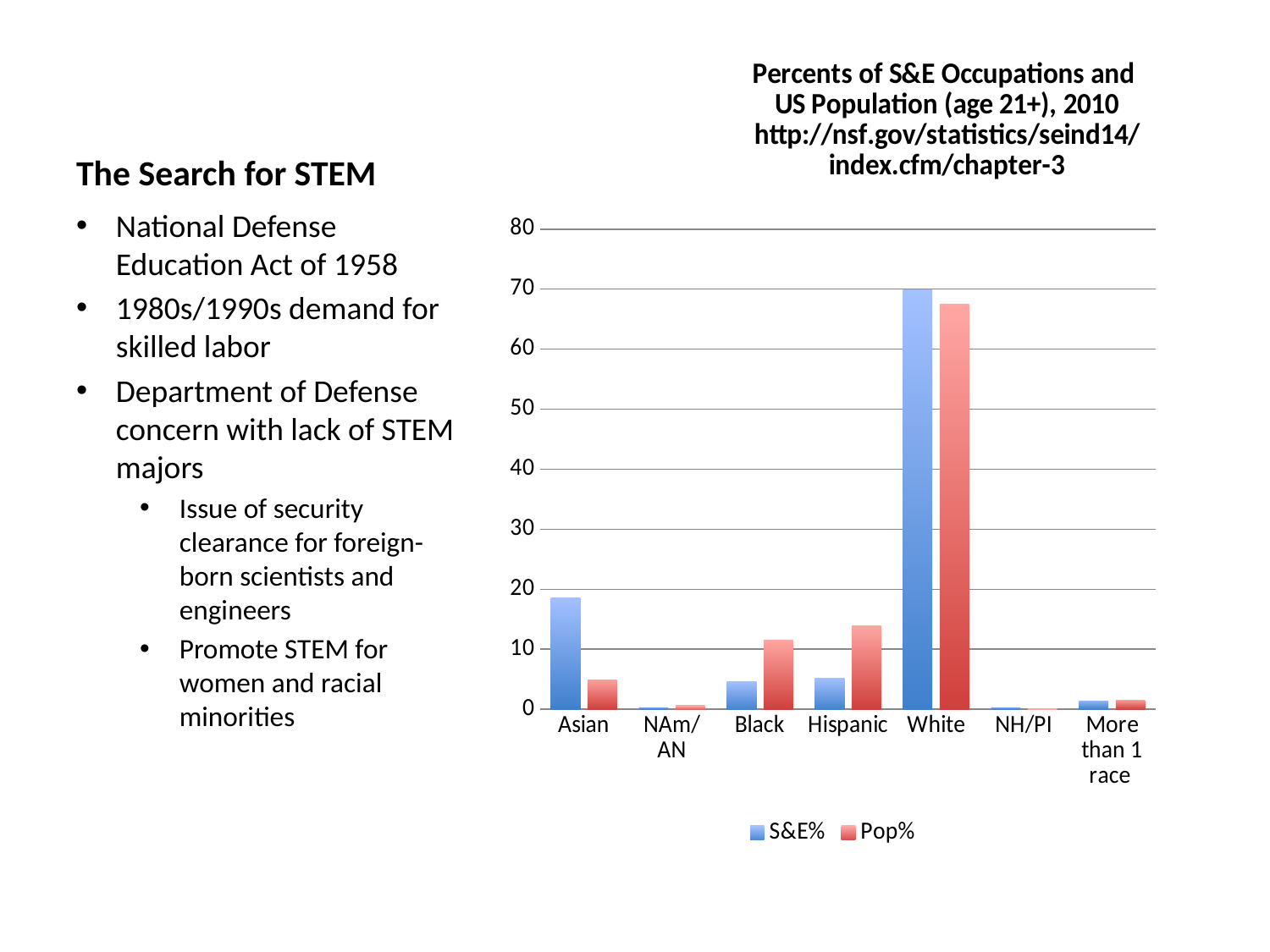
For Black, which is larger: S&E% or Pop%? Pop% Which category has the highest Pop% value? White How many categories are shown on the x axis of the chart? 7 Is the Pop% value for Asian greater or less than 10? less Is the S&E% value for White greater or less than 60? greater Which category has the highest S&E% value? White How many series does the chart's legend list? 2 What kind of chart is shown on the slide? bar chart What are the two series named in the chart's legend? S&E% and Pop% For Asian, which is larger: S&E% or Pop%? S&E% Is the Pop% value for Hispanic greater or less than 10? greater